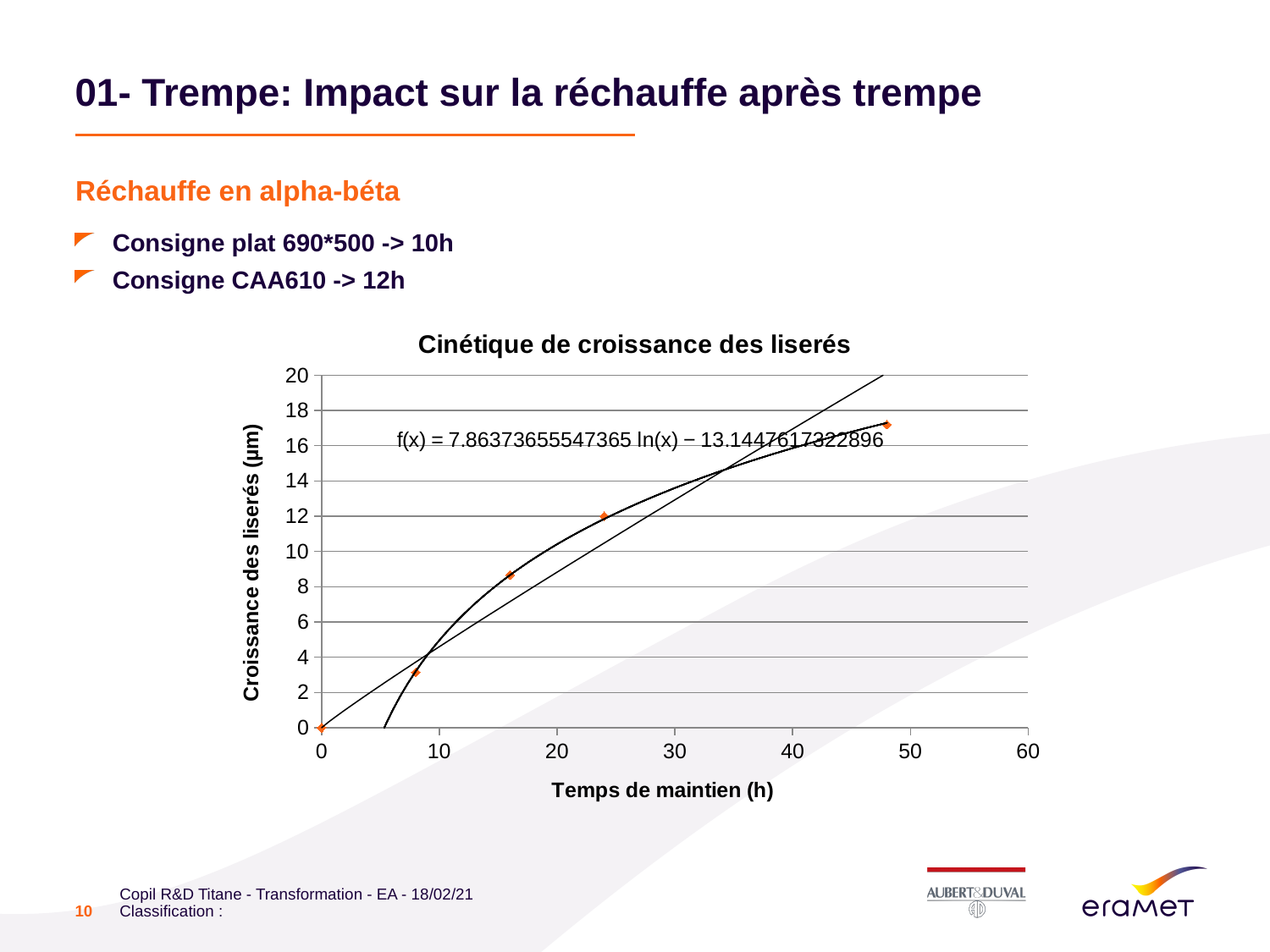
Do the plotted values rise or fall as the holding time (Temps de maintien) increases? rise Is the value for the point at about 48 h greater or less than 16? greater What is the title of the chart? Cinétique de croissance des liserés What kind of chart is shown on the slide? scatter chart with a trend line What is the label of the x axis of the chart? Temps de maintien (h) Is the value for the point at about 16 h greater or less than 8? greater How many data points are plotted on the chart? 5 What is the maximum value shown on the y axis of the chart? 20 Is the value for the point at about 8 h greater or less than 4? less Which holding time corresponds to the lowest plotted value? 0 What is the value of Croissance des liserés at a holding time of 0 h? 0 Which plotted point has the highest Croissance des liserés value: the one at about 24 h or the one at about 48 h? the one at about 48 h